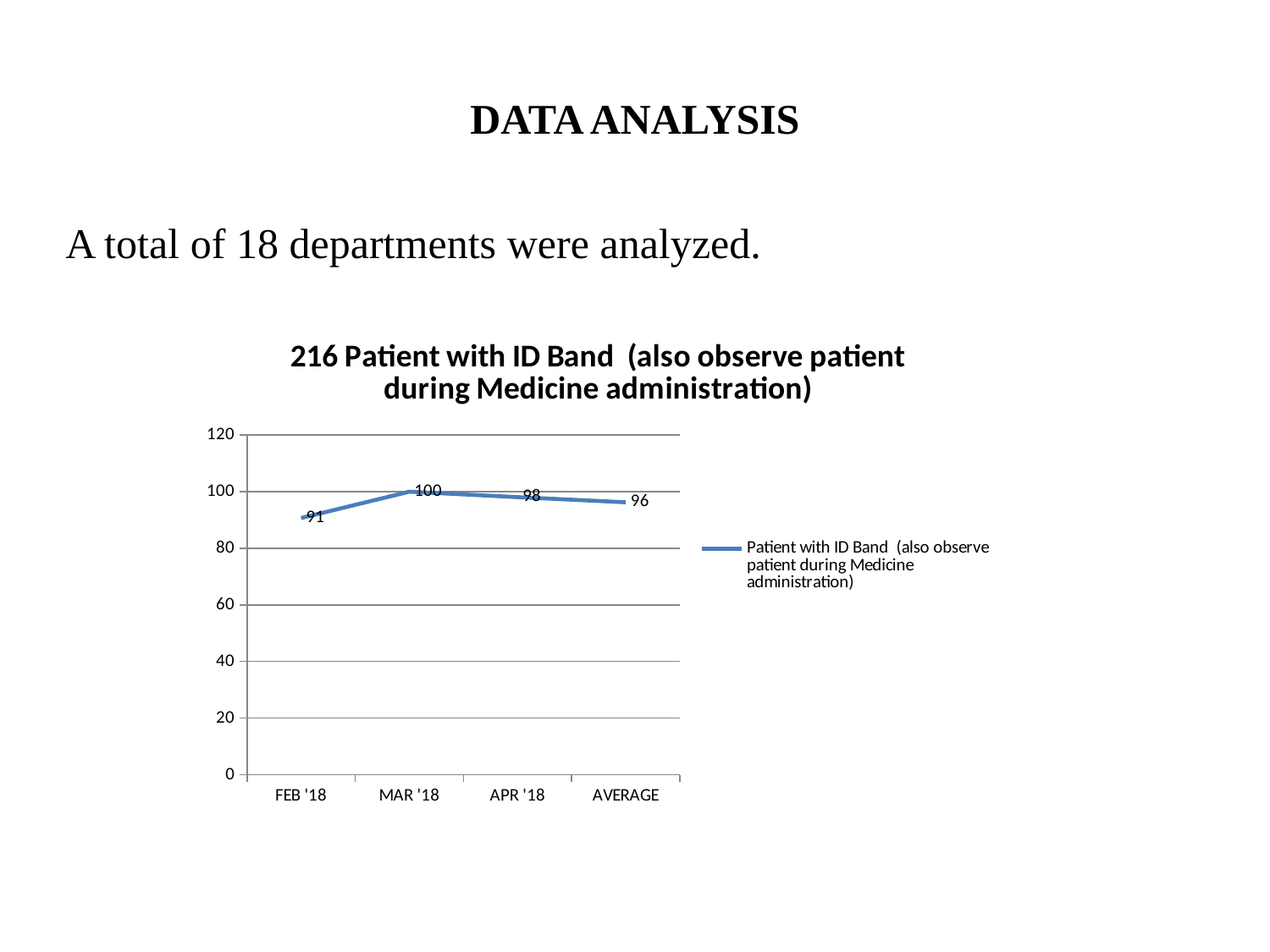
What is the value for FEB '18? 91 Which is larger, the value for APR '18 or the value for AVERAGE? APR '18 Is the value for FEB '18 greater or less than 100? less Which category has the lowest value? FEB '18 How many categories are shown on the x axis? 4 What is the value for AVERAGE? 96 Which category has the highest value? MAR '18 What is the difference between the values for MAR '18 and FEB '18? 9 What is the value for MAR '18? 100 What is the title of the chart? 216 Patient with ID Band (also observe patient during Medicine administration) What kind of chart is shown on the slide? line chart What is the value for APR '18? 98